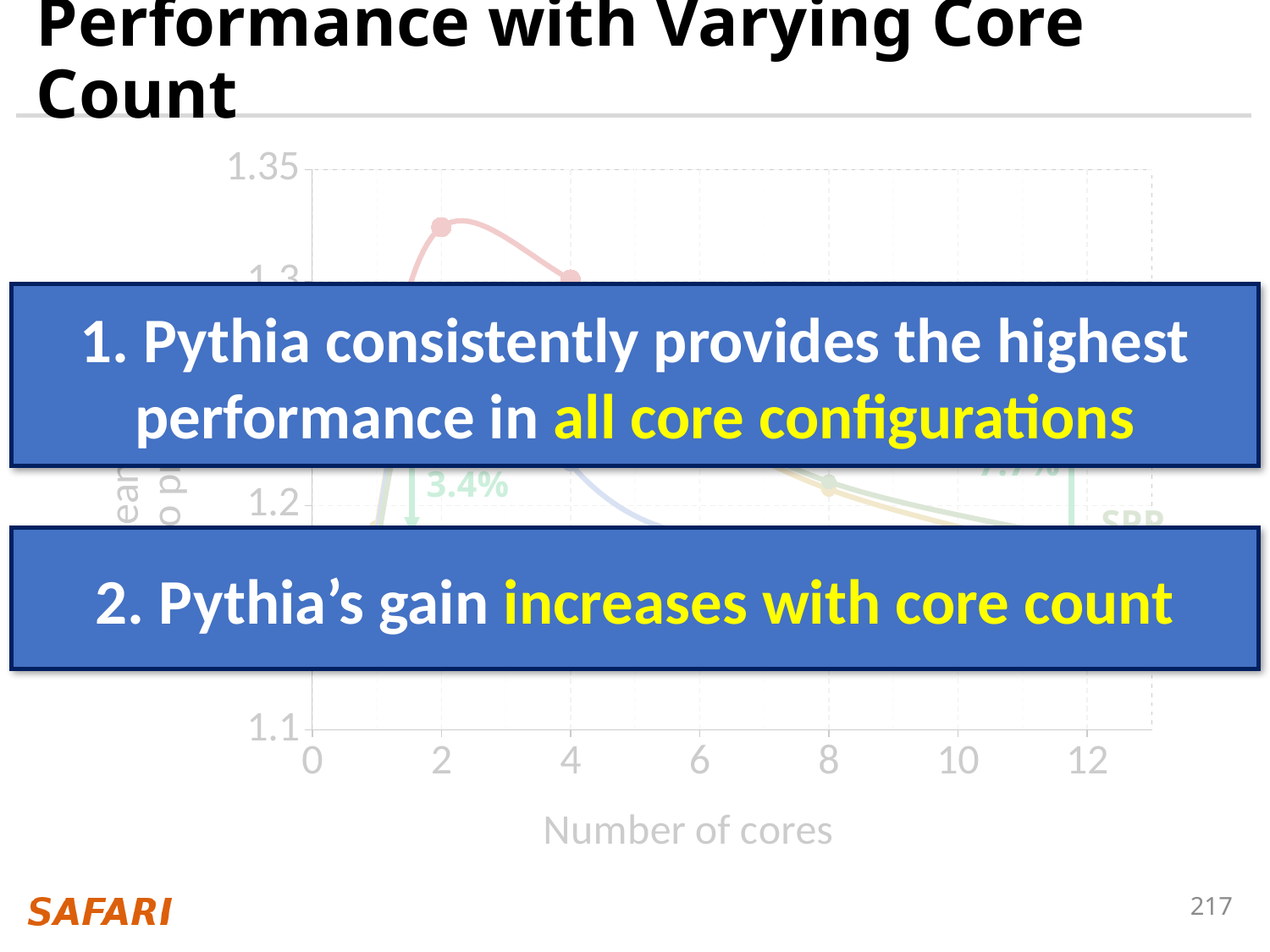
What is the label of the x axis of the chart? Number of cores Is the value of the red line at 2 cores greater or less than 1.3? greater What is the highest tick value shown on the y axis of the chart? 1.35 Does the red line rise or fall between 2 cores and 4 cores? fall What kind of chart is shown on the slide? line chart